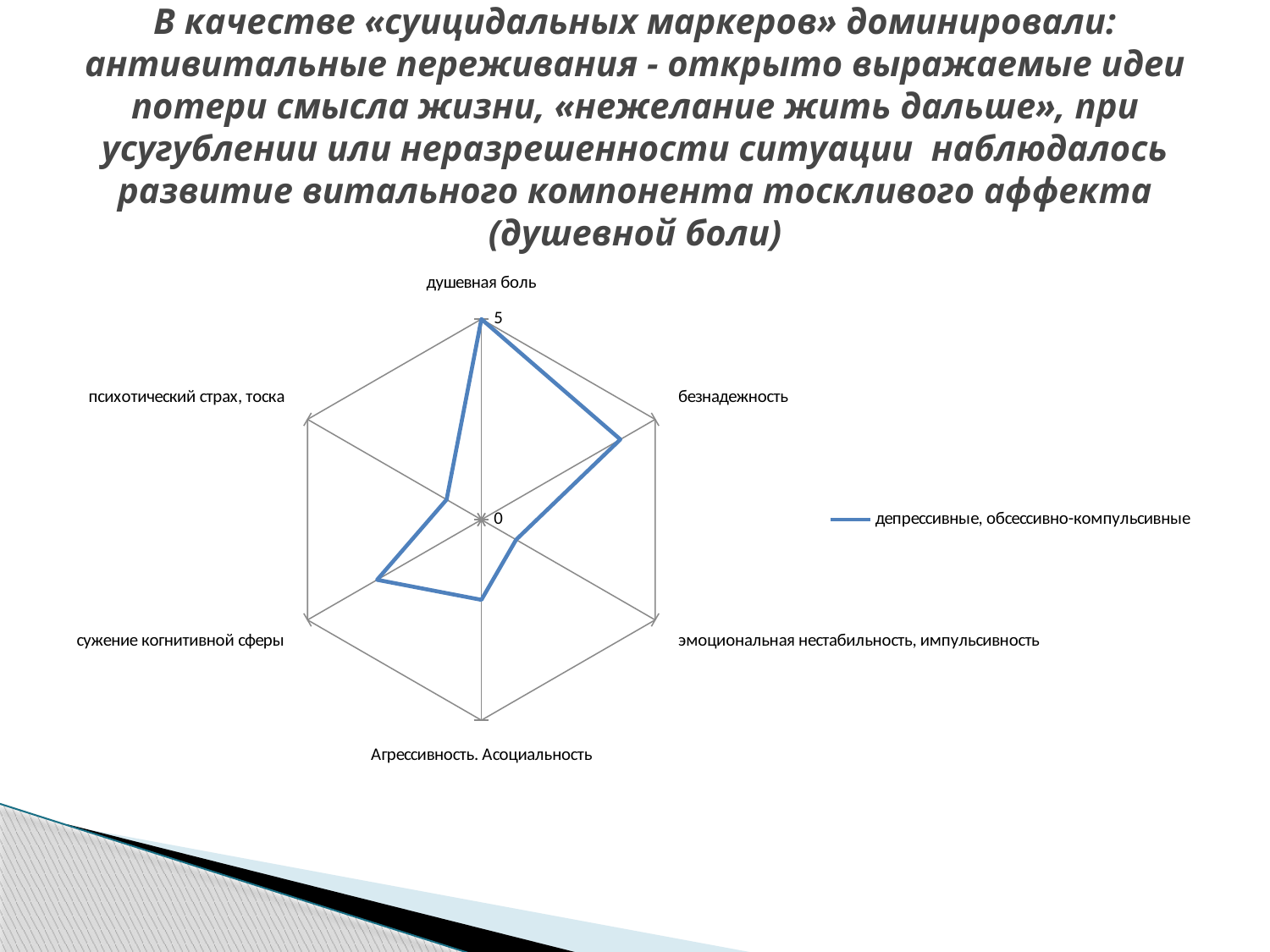
Which category has the highest value on the radar chart? душевная боль Which is larger: the value for сужение когнитивной сферы or the value for Агрессивность. Асоциальность? сужение когнитивной сферы What is the maximum value labelled on the radar chart's axis? 5 What is the name of the series shown in the legend? депрессивные, обсессивно-компульсивные What is the value for душевная боль? 5 How many series does the legend list? 1 Which is larger: the value for сужение когнитивной сферы or the value for психотический страх, тоска? сужение когнитивной сферы Which is larger: the value for безнадежность or the value for эмоциональная нестабильность, импульсивность? безнадежность What kind of chart is shown on the slide? radar chart How many categories (axes) does the radar chart have? 6 Is the value for безнадежность greater or less than 5? less